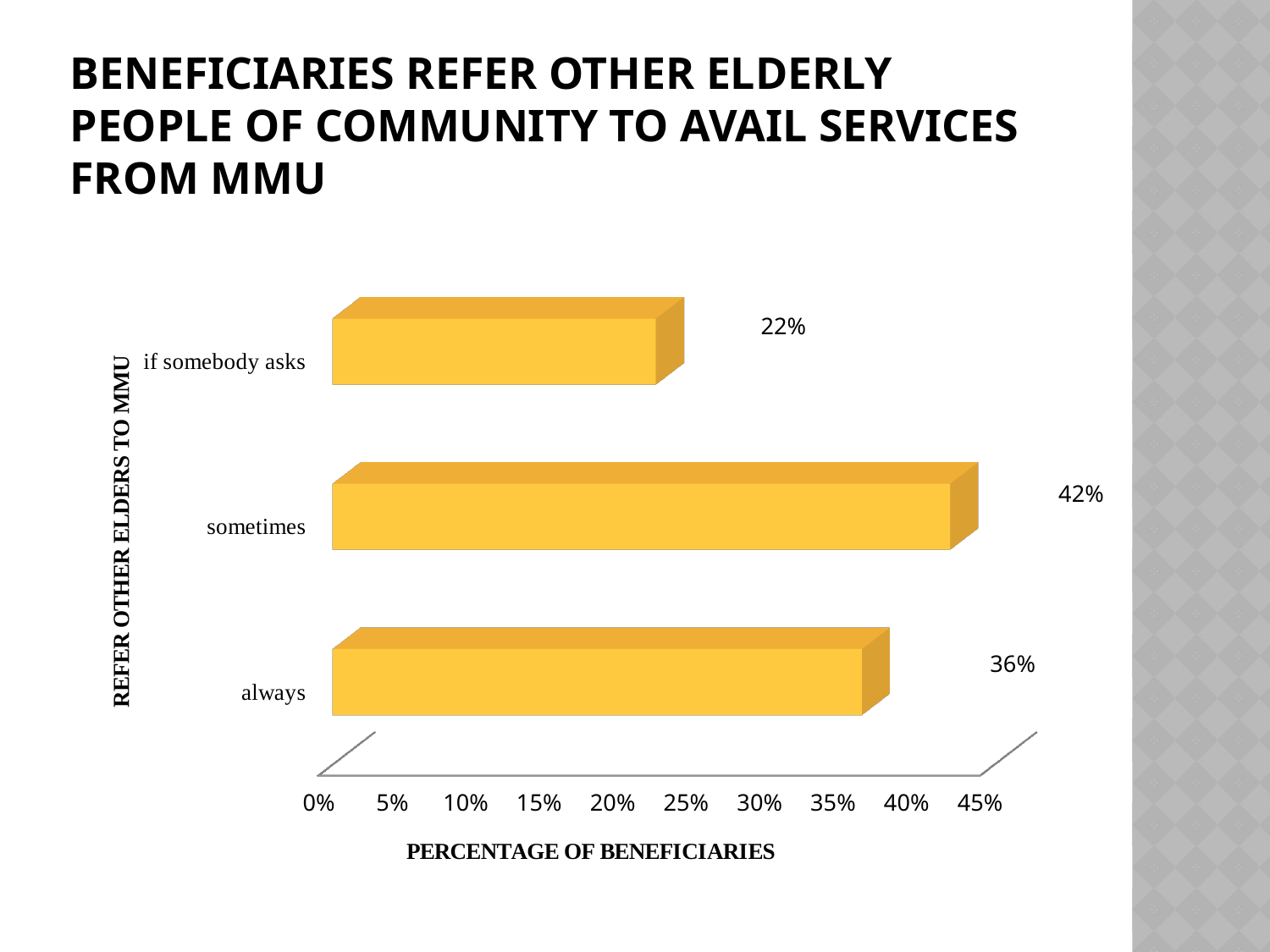
What is the label of the horizontal axis? PERCENTAGE OF BENEFICIARIES What kind of chart is shown on the slide? bar chart What is the difference between the percentages for "always" and "if somebody asks"? 14% Which is larger, the value for "always" or the value for "if somebody asks"? always Which category has the highest percentage of beneficiaries? sometimes How many categories are shown on the chart? 3 Which category has the lowest percentage of beneficiaries? if somebody asks What is the difference between the percentages for "sometimes" and "always"? 6% Is the value for "sometimes" greater or less than 40%? greater What percentage of beneficiaries answered "sometimes"? 42% What percentage of beneficiaries answered "if somebody asks"? 22% What percentage of beneficiaries answered "always"? 36%